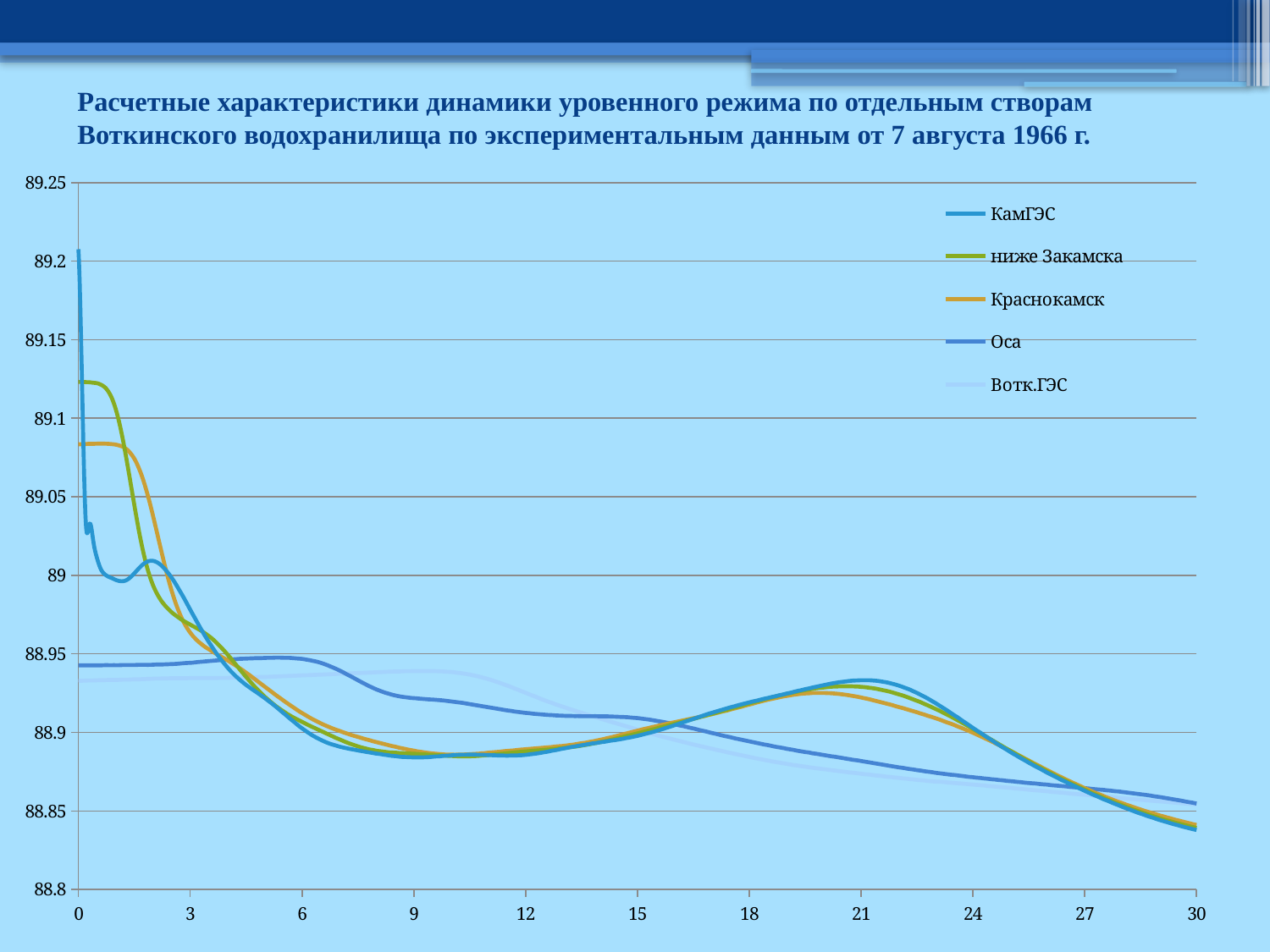
Which series has the highest value at x = 0? КамГЭС Is the value for ниже Закамска at x = 0 greater or less than 89.1? greater How many series does the legend list? 5 Is the value for Краснокамск at x = 0 greater or less than 89.1? less Which series is listed first in the legend? КамГЭС Is the value for КамГЭС at x = 0 greater or less than 89.15? greater At x = 0, which is higher: ниже Закамска or Краснокамск? ниже Закамска Does the Оса series rise or fall between x = 6 and x = 30? fall What is the highest value shown on the vertical axis? 89.25 What kind of chart is shown on the slide? line chart